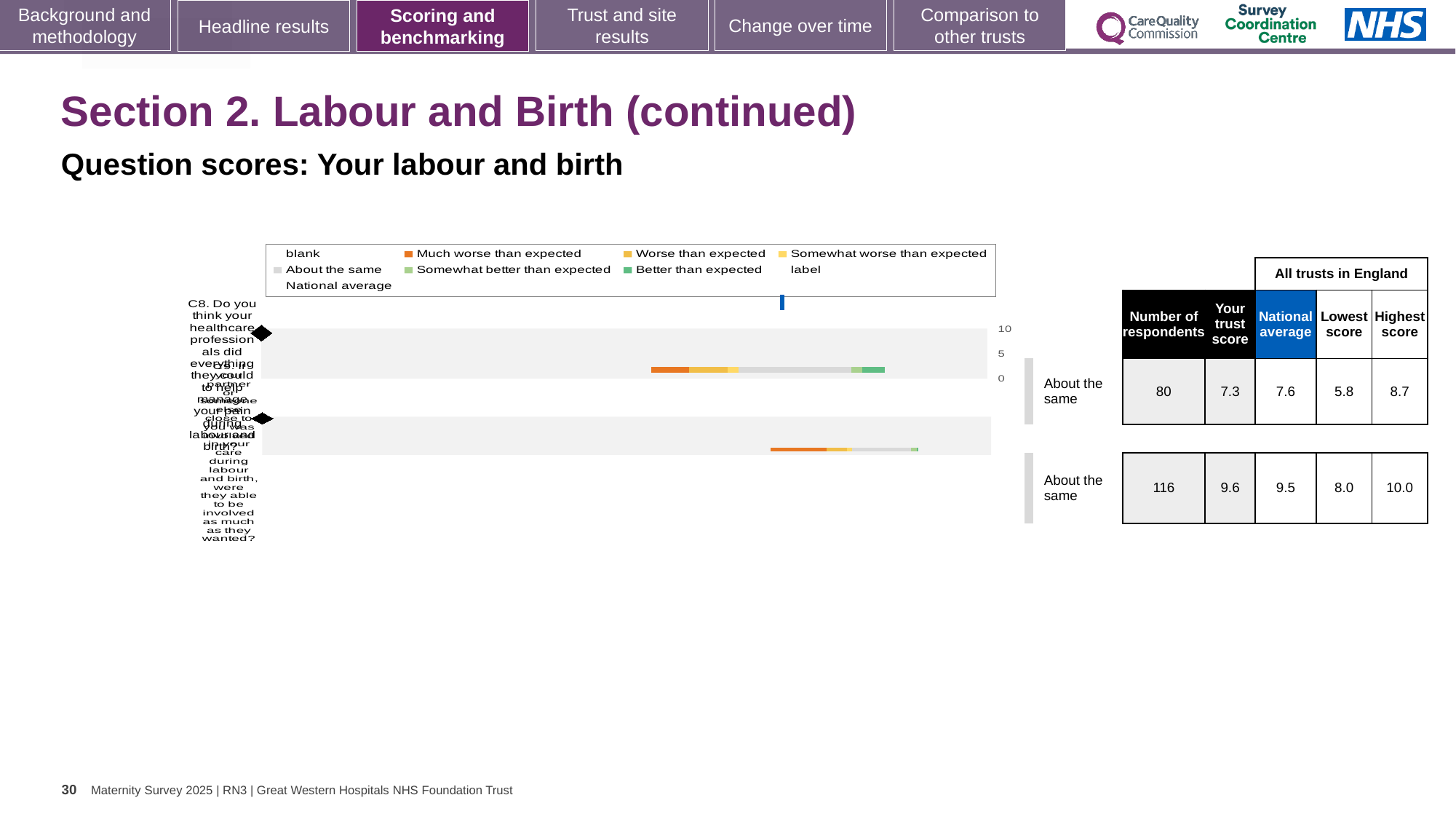
In the table, what is the National average for the top row? 7.6 In the chart legend, what colour represents 'Much worse than expected'? orange What kind of chart is shown on the slide? bar chart In the table, what is the 'Your trust score' for the top row? 7.3 For the top row of the table, which is larger: the trust score or the National average? National average In the table, what is the Number of respondents for the bottom row? 116 In the chart legend, what colour represents 'Better than expected'? green For the bottom row of the table, which is larger: the trust score or the National average? Your trust score In the table, what is the Highest score for the bottom row? 10.0 For the top row of the table, what is the difference between the Highest score and the Lowest score? 2.9 What benchmark category is shown next to both rows of the chart? About the same How many question rows (bars) does the chart show? 2